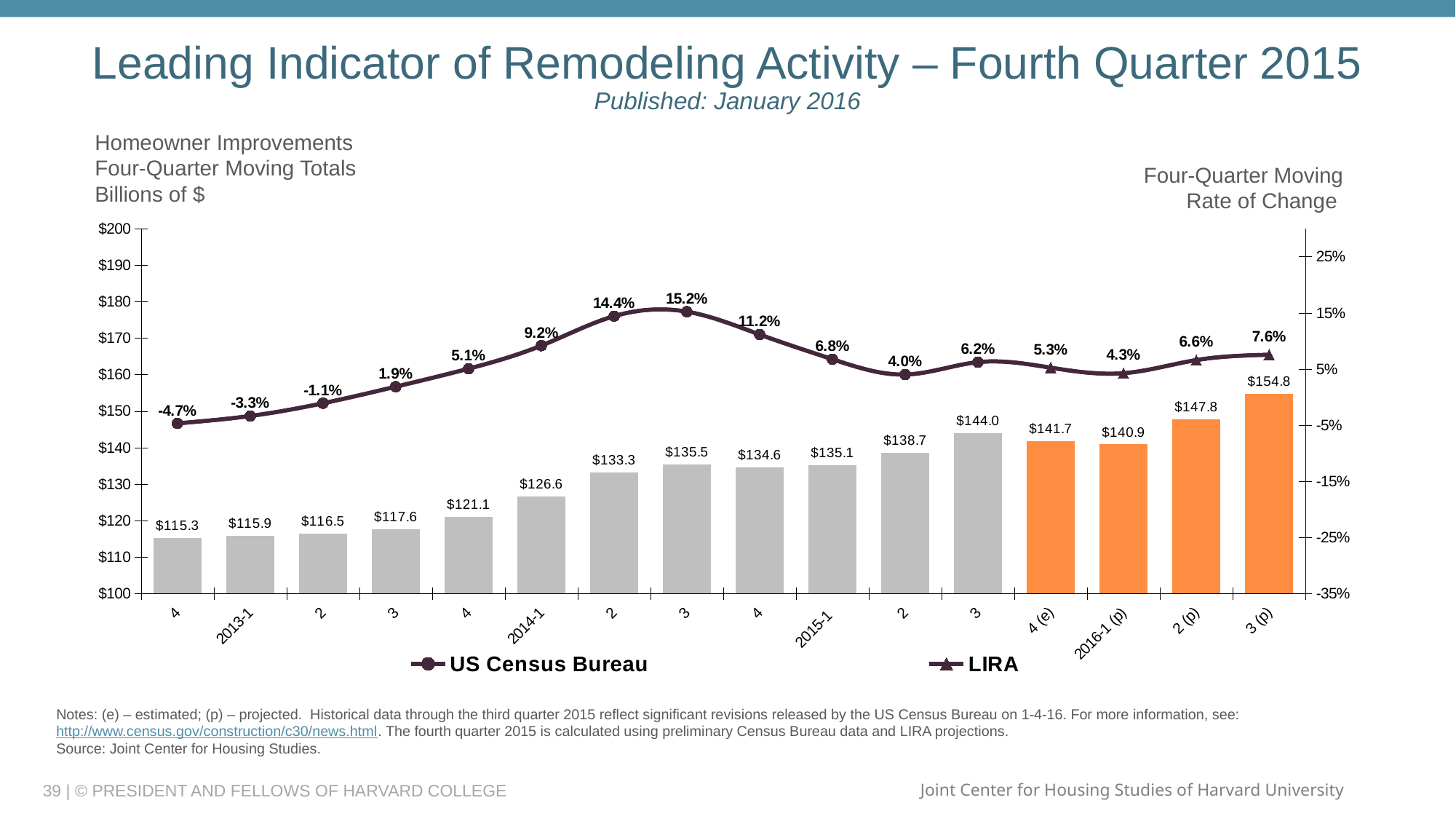
What is the four-quarter moving rate of change for 2015-1? 6.8% How many quarters are plotted along the x axis? 16 What is the four-quarter moving total for 2014-1? $126.6 What is the highest four-quarter moving rate of change shown on the chart? 15.2% What is the lowest four-quarter moving total shown on the chart? $115.3 What is the four-quarter moving rate of change for the 4 (e) quarter? 5.3% How much larger is the four-quarter moving total for 3 (p) than for 2016-1 (p)? $13.9 Does the four-quarter moving rate of change rise or fall from 2014 quarter 3 to 2015 quarter 2? Fall What kind of chart is shown on the slide? Bar chart with a line Which has the larger four-quarter moving total, 2015 quarter 2 or 2015 quarter 3? 2015 quarter 3 ($144.0) How many series does the legend list? 2 Which quarter has the highest four-quarter moving total? 3 (p) (2016), $154.8